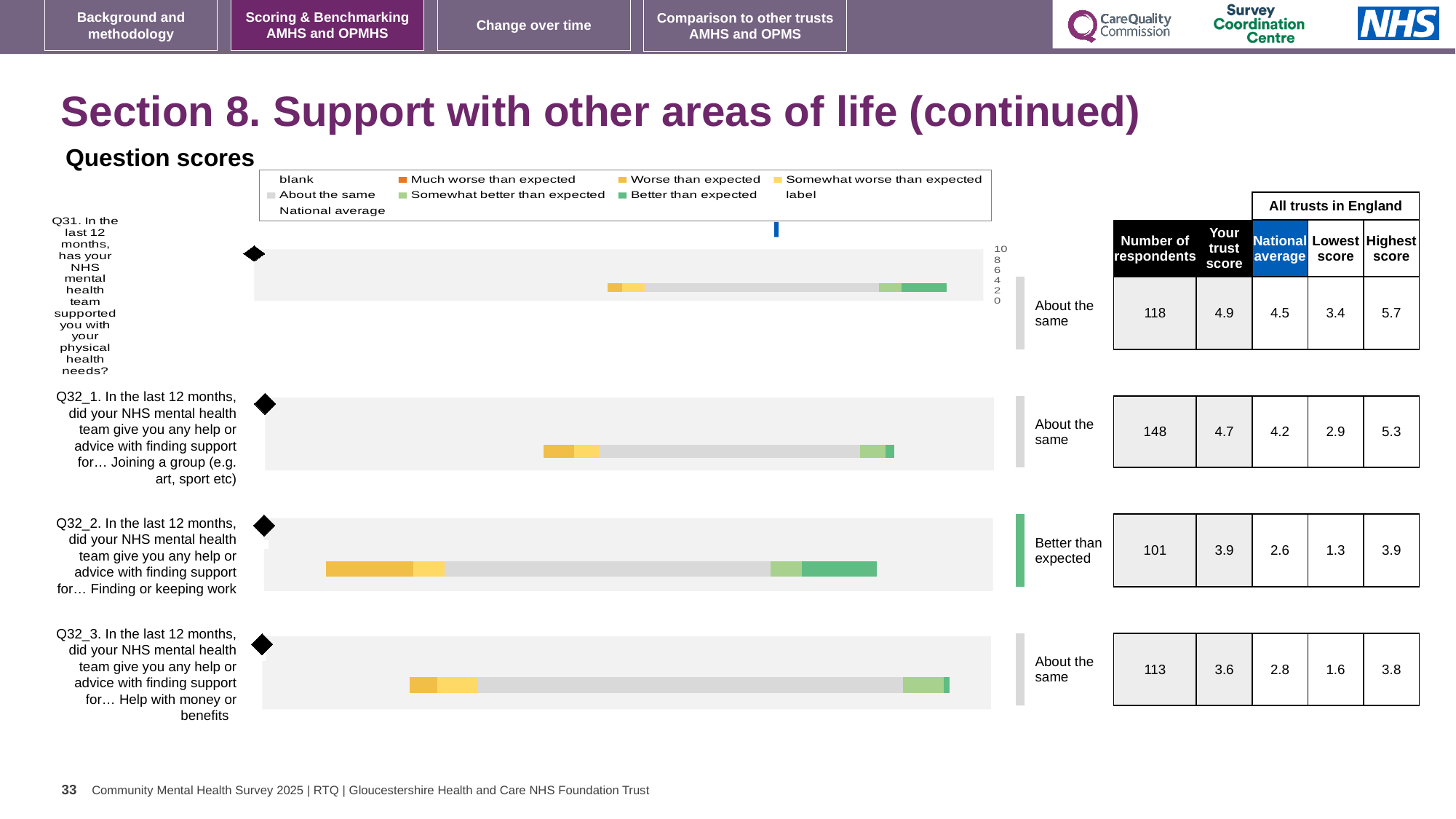
In the question scores chart, which question has the lowest trust score? Q32_3 (help with money or benefits) In the question scores chart, what is the highest score across all trusts in England for Q32_3 (help with money or benefits)? 3.8 In the question scores chart, which question is rated 'Better than expected'? Q32_2 (finding or keeping work) In the question scores chart, what is the trust score for Q32_1 (help with joining a group)? 4.7 How many entries does the legend of the question scores chart list? 9 What kind of chart is used to show the question scores on this slide? bar chart In the question scores chart, is the trust score for Q32_2 higher or lower than the national average? higher How many questions (bars) are plotted in the question scores chart? 4 In the question scores chart, which question has the highest number of respondents? Q32_1 (joining a group) In the question scores chart, what is the national average for Q32_2 (help with finding or keeping work)? 2.6 In the question scores chart, what is the difference between the trust score and the national average for Q31? 0.4 In the question scores chart, what is the number of respondents for Q31 (support with physical health needs)? 118